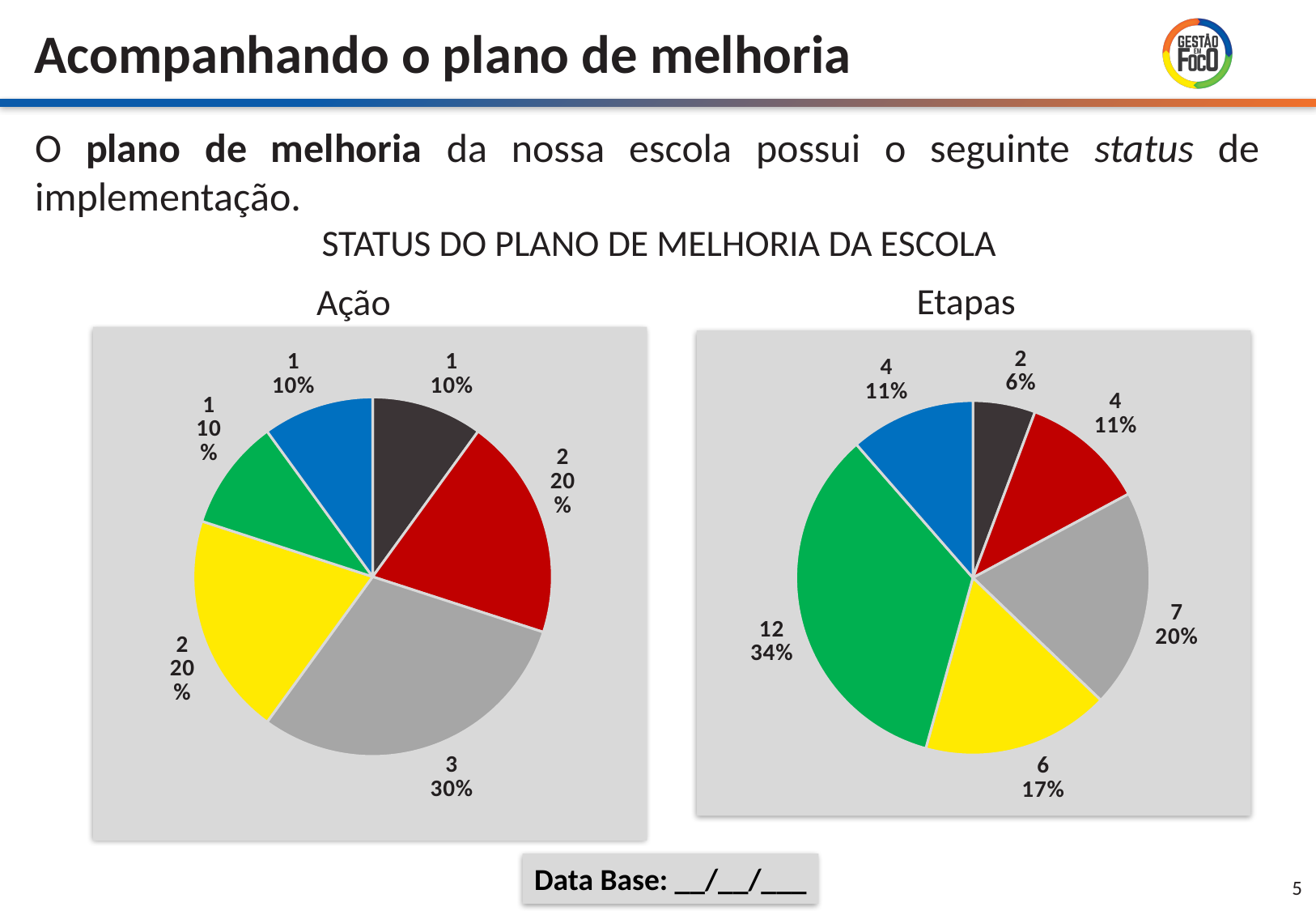
In the "Etapas" chart, what is the value shown on the largest slice (green)? 12 In the "Etapas" chart, what percentage does the smallest slice (dark grey) represent? 6% In the "Etapas" chart, what percentage is shown on the yellow slice? 17% In the "Ação" chart, what percentage does the largest slice (grey) represent? 30% In the "Etapas" chart, what is the difference between the value of the green slice and the value of the grey slice? 5 What type of chart is used for the "Ação" chart? pie chart What is the overall title shown above the two pie charts? STATUS DO PLANO DE MELHORIA DA ESCOLA In the "Etapas" chart, which slice is larger: the grey slice or the yellow slice? grey slice How many slices does the "Etapas" pie chart have? 6 What is the total of the values shown on all slices of the "Etapas" chart? 35 What is the total of the values shown on all slices of the "Ação" chart? 10 In the "Ação" chart, what value is shown on the red slice? 2